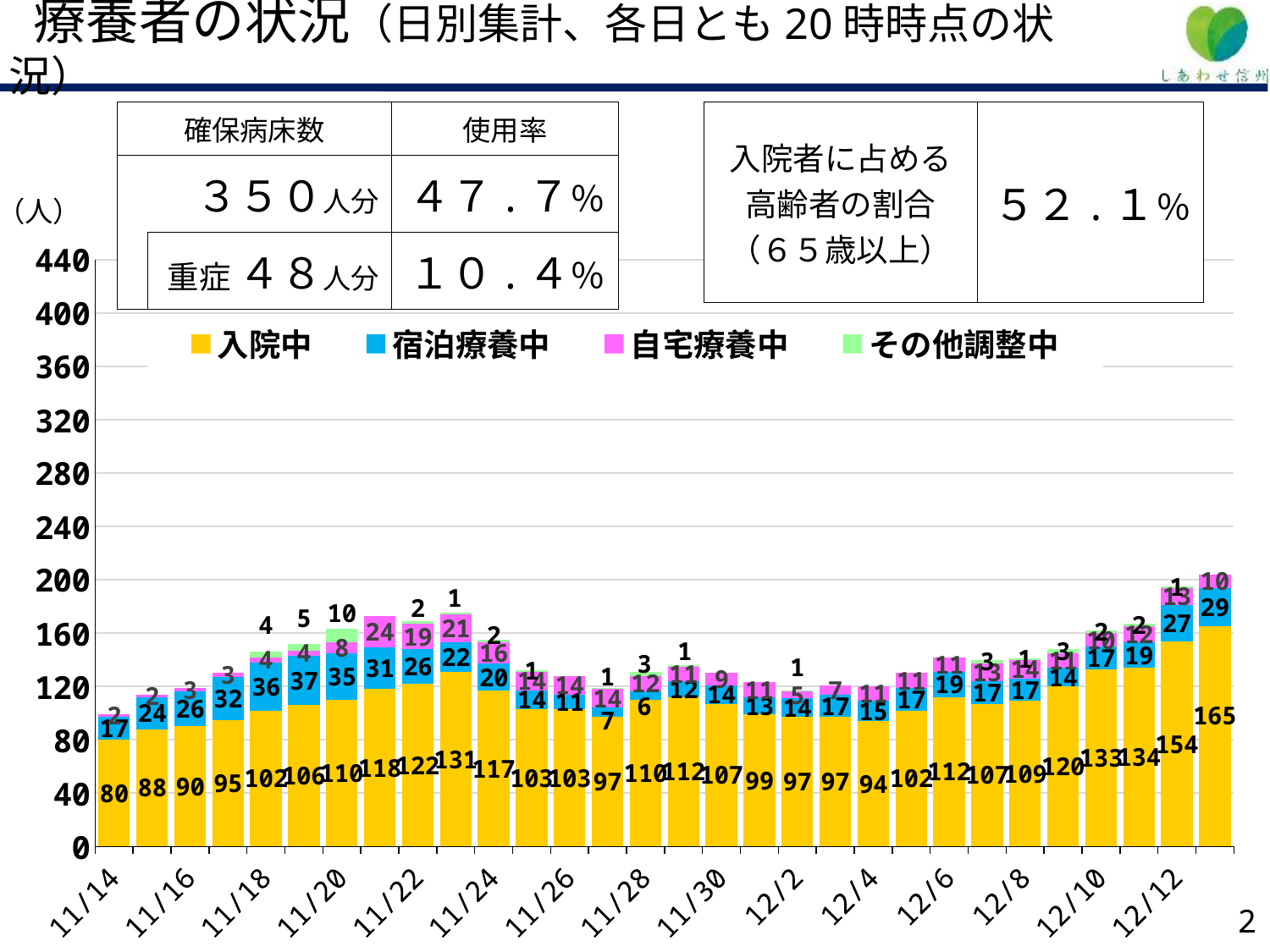
What is the highest 入院中 value shown in the chart? 165 What is the 宿泊療養中 value for 11/18? 36 What is the difference between the 入院中 values for 12/12 and 11/14? 74 What colour represents 入院中 in the chart? Yellow How many series does the legend list? 4 What is the 入院中 value for 12/12? 154 What is the 入院中 value for 11/14? 80 Which date has the larger 宿泊療養中 value, 11/18 or 11/28? 11/18 Does the 入院中 value rise or fall from 12/4 to 12/12? Rises What is the total height of the stacked bar for 11/20? 163 Which date has the lowest 入院中 value? 11/14 What kind of chart is shown on the slide? Stacked bar chart